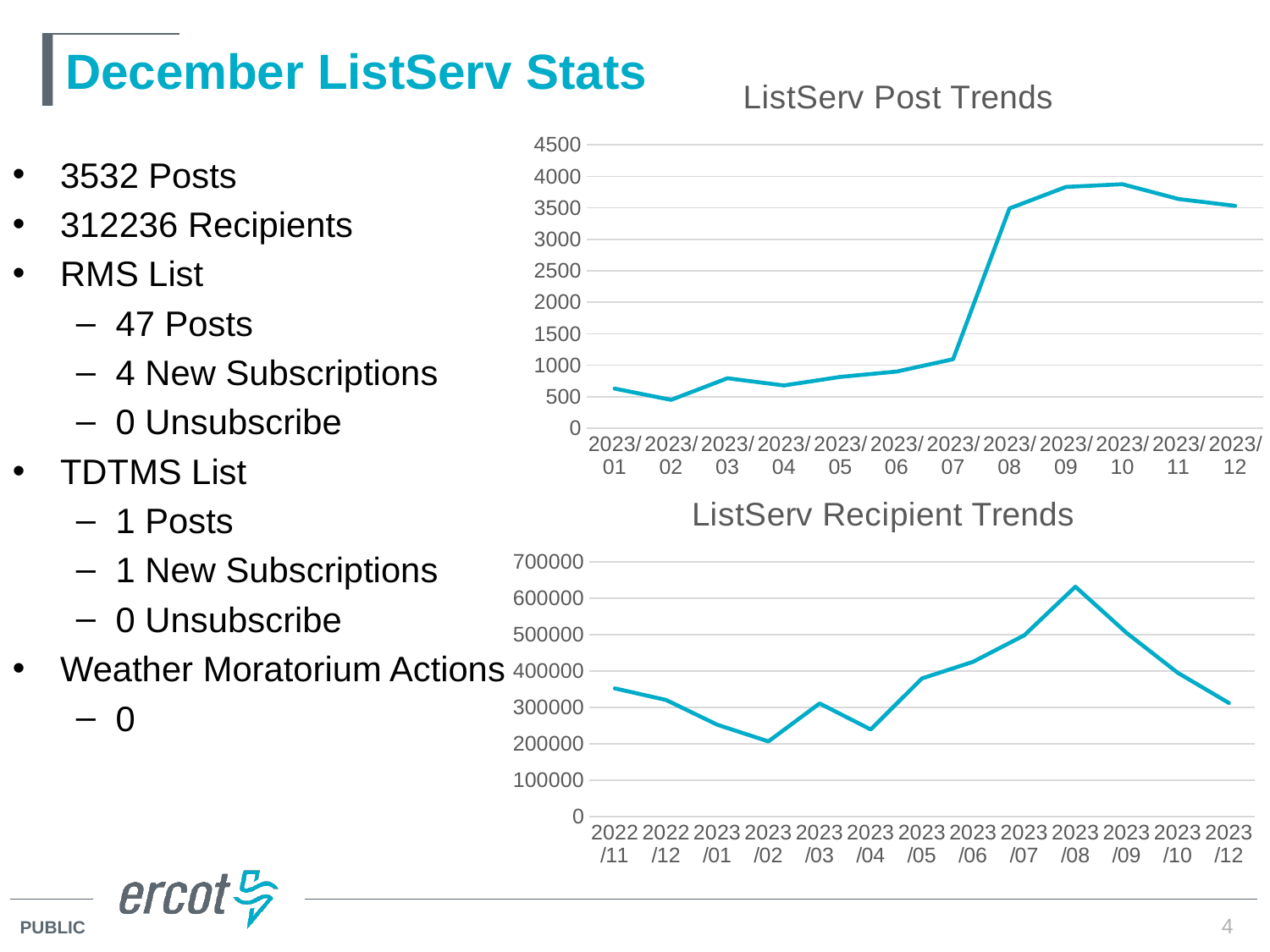
In the ListServ Recipient Trends chart, which month has the lowest value? 2023/02 What kind of chart is the ListServ Recipient Trends chart? line chart How many months are plotted on the ListServ Post Trends chart? 12 In the ListServ Post Trends chart, is the value for 2023/07 greater or less than 1500? less In the ListServ Recipient Trends chart, is the value for 2023/08 greater or less than 600000? greater In the ListServ Post Trends chart, is the value for 2023/08 greater or less than 3000? greater In the ListServ Recipient Trends chart, which is larger, the value for 2023/07 or the value for 2023/04? 2023/07 In the ListServ Recipient Trends chart, which month has the highest value? 2023/08 How many months are plotted on the ListServ Recipient Trends chart? 13 What kind of chart is the ListServ Post Trends chart? line chart In the ListServ Post Trends chart, which month has the lowest value? 2023/02